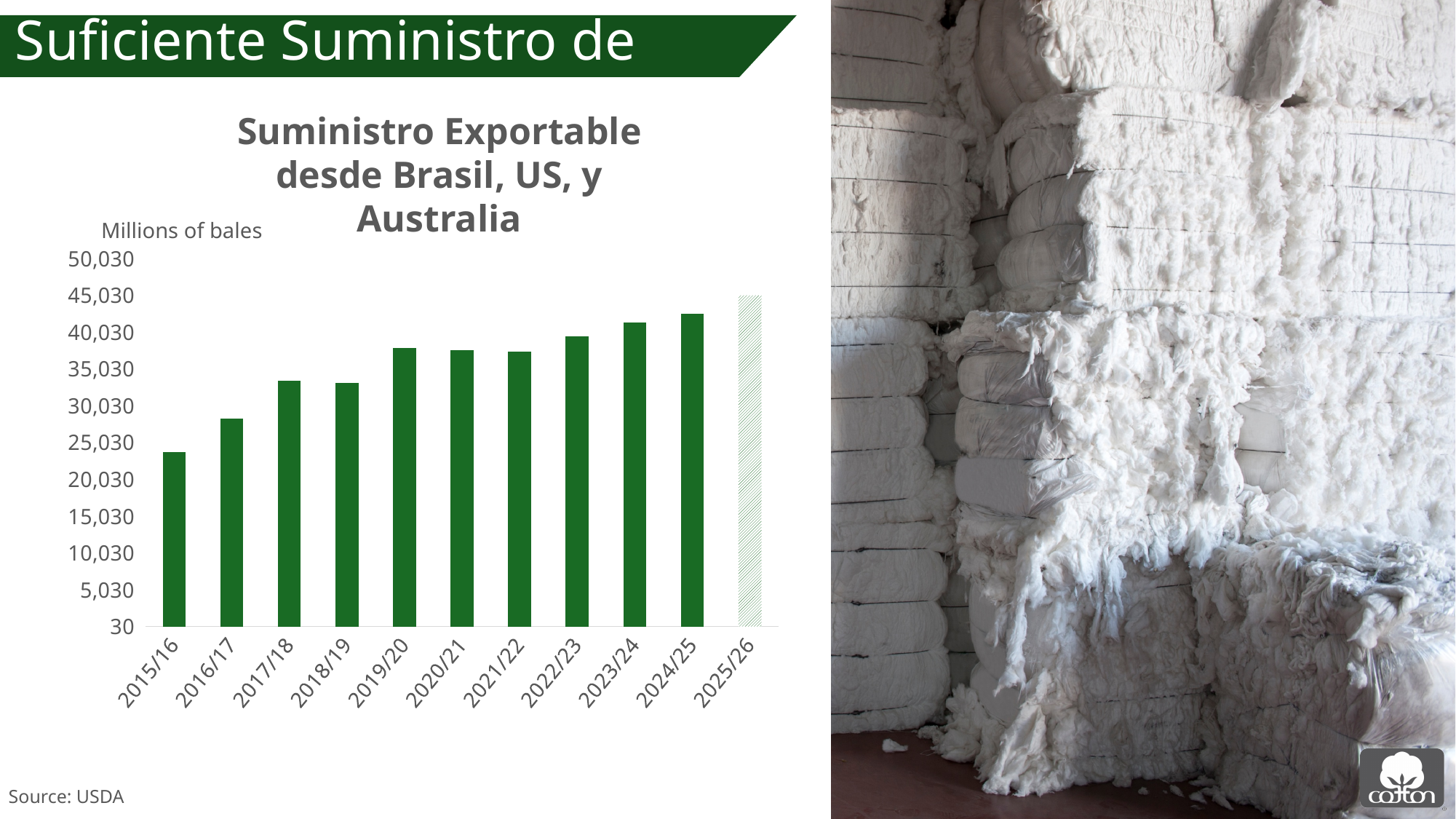
Do the values generally rise or fall from 2015/16 to 2025/26? rise What unit is given for the vertical axis of the chart? Millions of bales Is the value for 2019/20 greater or less than 40,030? less How many seasons (bars) are plotted on the chart? 11 Is the value for 2024/25 greater or less than 40,030? greater Which season has the lowest exportable supply on the chart? 2015/16 Which season has the highest exportable supply on the chart? 2025/26 Is the value for 2017/18 greater or less than 30,030? greater What kind of chart is shown on the slide? bar chart Which is larger, the value for 2022/23 or the value for 2024/25? 2024/25 Which is larger, the value for 2015/16 or the value for 2016/17? 2016/17